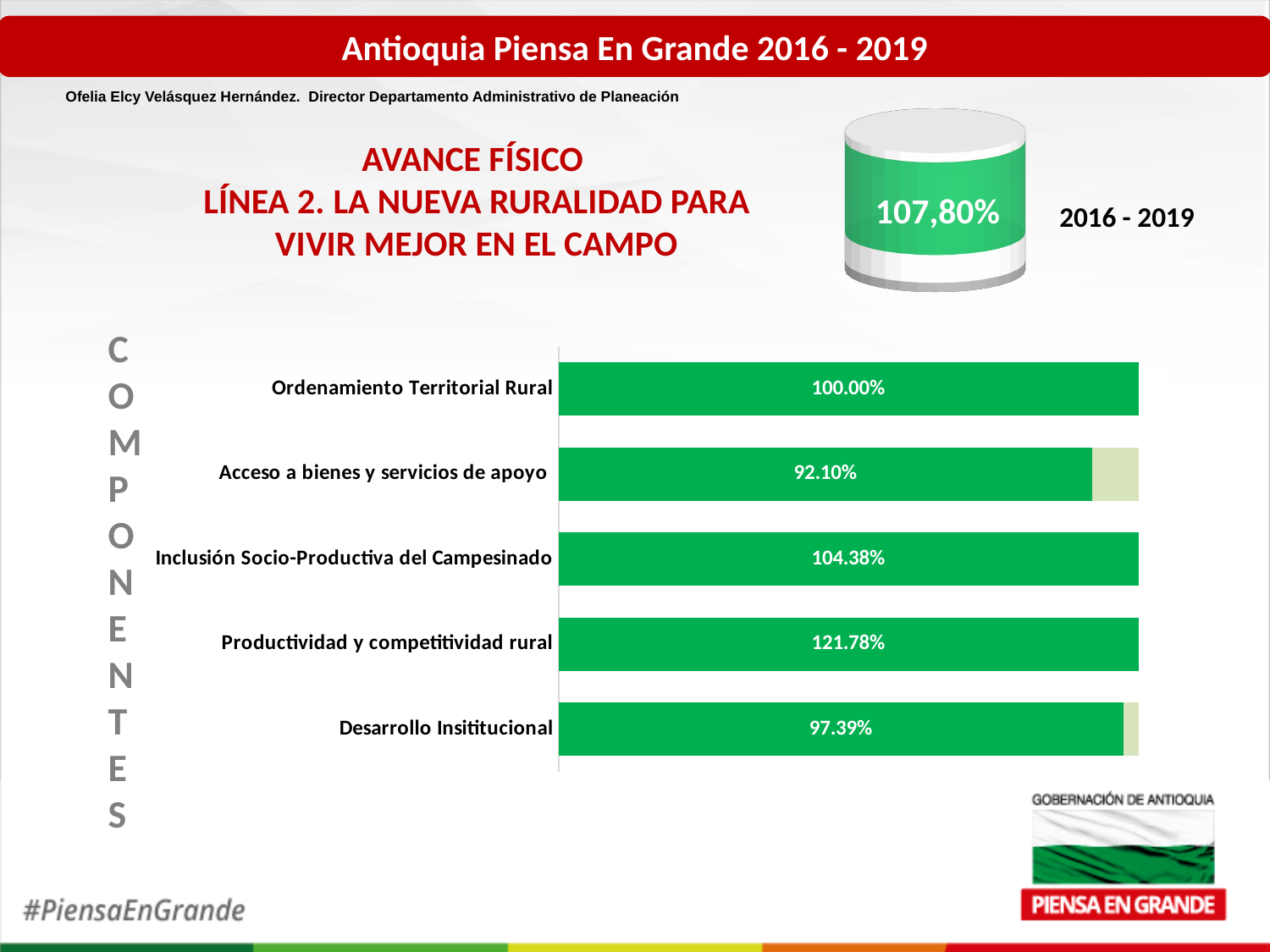
What is the value for Ordenamiento Territorial Rural? 100.00% Which component has the highest value? Productividad y competitividad rural What kind of chart is shown on the slide? Bar chart What is the difference between the values for Productividad y competitividad rural and Acceso a bienes y servicios de apoyo? 29.68% Which is larger, the value for Inclusión Socio-Productiva del Campesinado or the value for Desarrollo Insititucional? Inclusión Socio-Productiva del Campesinado What is the value for Acceso a bienes y servicios de apoyo? 92.10% What overall percentage is shown in the cylinder graphic next to the title? 107,80% How many components are shown in the chart? 5 What is the value for Productividad y competitividad rural? 121.78% What is the value for Inclusión Socio-Productiva del Campesinado? 104.38% Which component has the lowest value? Acceso a bienes y servicios de apoyo What is the value for Desarrollo Insititucional? 97.39%